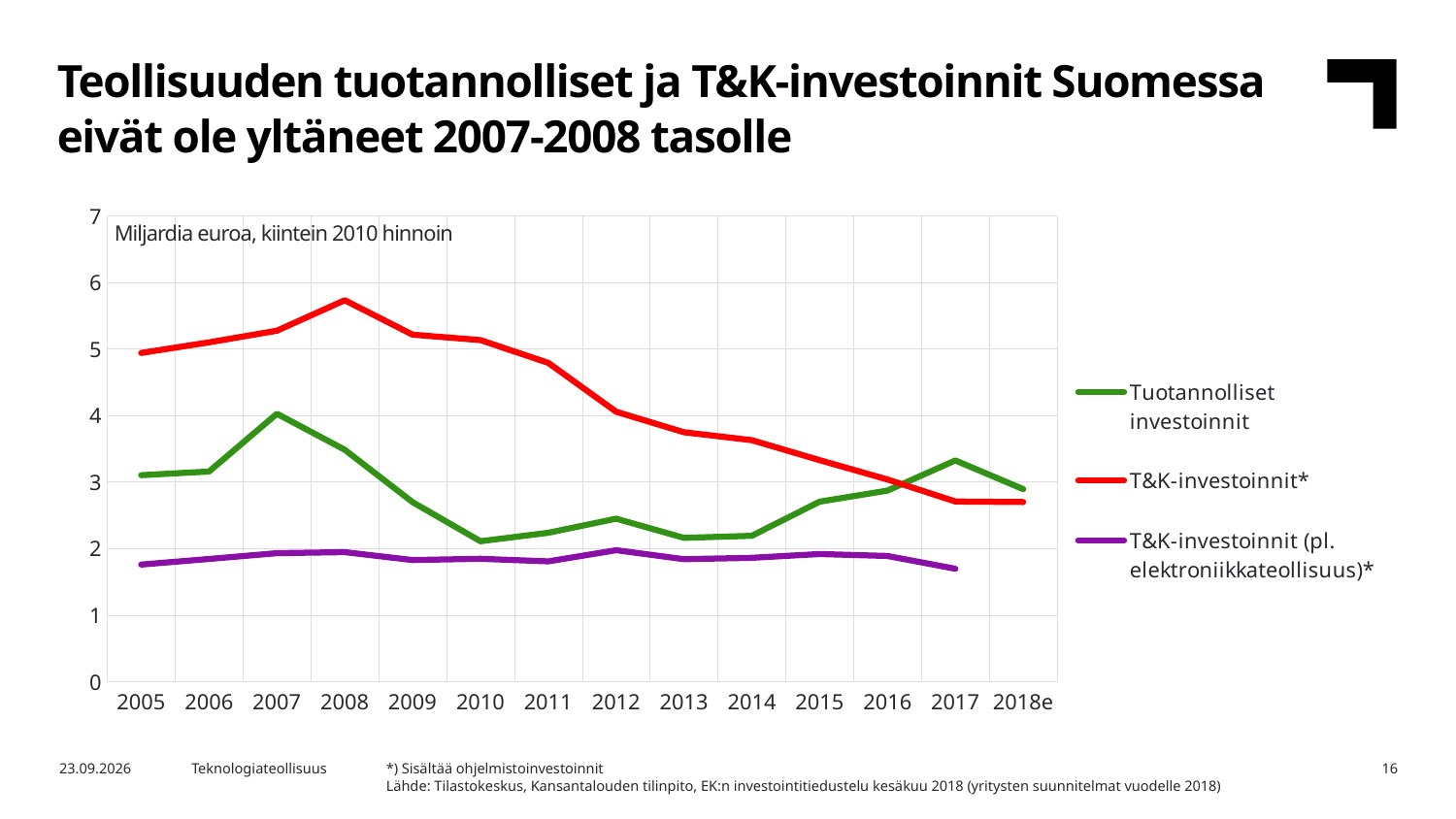
In 2005, which is higher: T&K-investoinnit* or Tuotannolliset investoinnit? T&K-investoinnit* In which year does the T&K-investoinnit* series reach its highest value? 2008 How many years are shown on the x axis? 14 Does the T&K-investoinnit* series rise or fall from 2008 to 2017? Fall Is the value for T&K-investoinnit* in 2008 greater or less than 5? greater Is the value for Tuotannolliset investoinnit in 2010 greater or less than 3? less In 2017, which is higher: Tuotannolliset investoinnit or T&K-investoinnit*? Tuotannolliset investoinnit Is the value for T&K-investoinnit (pl. elektroniikkateollisuus)* in 2017 greater or less than 2? less In which year does the Tuotannolliset investoinnit series reach its highest value? 2007 What type of chart is shown on the slide? Line chart What unit label is shown inside the chart area? Miljardia euroa, kiintein 2010 hinnoin How many series does the legend list? 3